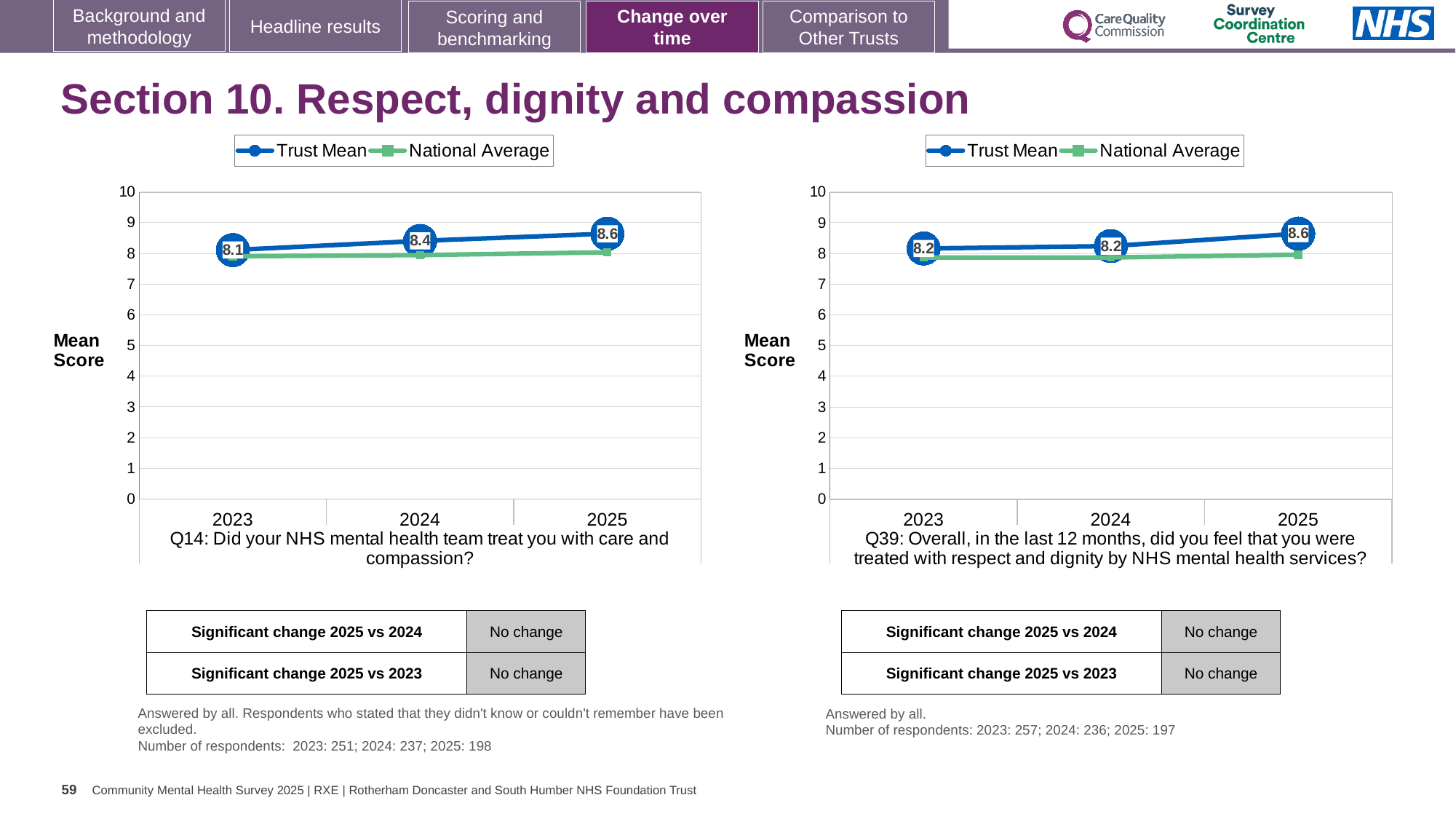
On the Q39 chart (right), in 2025 which series is higher, Trust Mean or National Average? Trust Mean On the Q14 chart (left), what is the Trust Mean score for 2025? 8.6 On the Q14 chart (left), which year has the lowest Trust Mean score? 2023 How many years are shown on the x axis of the Q14 chart (left)? 3 What type of chart is the Q14 chart (left)? Line chart On the Q39 chart (right), what is the difference between the Trust Mean scores for 2025 and 2024? 0.4 On the Q14 chart (left), what is the difference between the Trust Mean scores for 2025 and 2023? 0.5 How many series does the legend of the Q39 chart (right) list? 2 On the Q39 chart (right), what is the Trust Mean score for 2024? 8.2 On the Q39 chart (right), which year has the highest Trust Mean score? 2025 On the Q14 chart (left), what is the Trust Mean score for 2023? 8.1 On the Q14 chart (left), is the National Average value for 2025 greater or less than 9? less